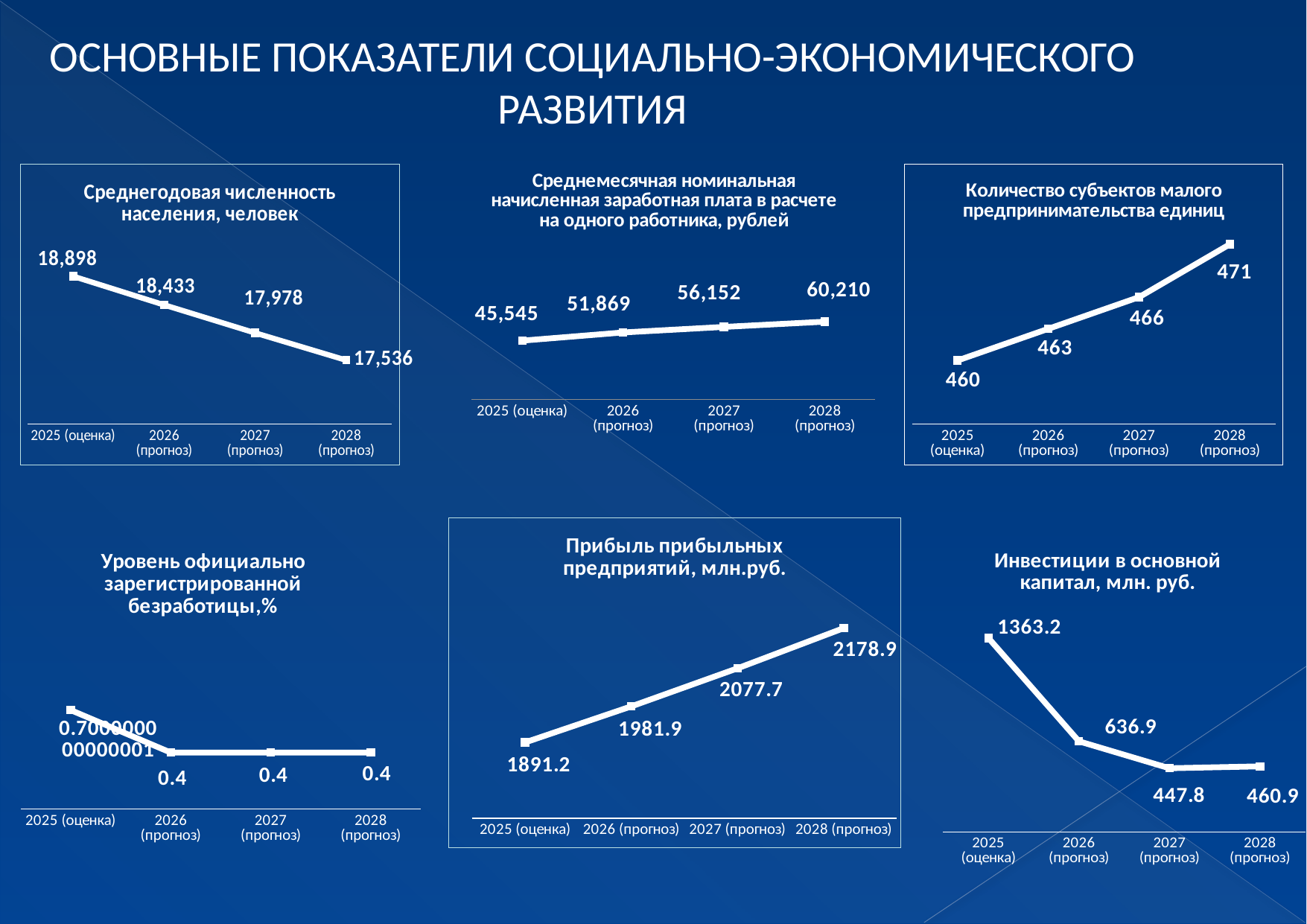
In the chart 'Прибыль прибыльных предприятий, млн.руб.', what is the value for 2025 (оценка)? 1891.2 In the chart 'Инвестиции в основной капитал, млн. руб.', which is larger: the value for 2026 or the value for 2028? 2026 In the chart 'Количество субъектов малого предпринимательства единиц', what is the difference between the 2028 and 2025 values? 11 In the chart 'Среднегодовая численность населения, человек', do the values rise or fall from 2025 to 2028? fall In the chart 'Среднемесячная номинальная начисленная заработная плата в расчете на одного работника, рублей', what is the value for 2026 (прогноз)? 51,869 In the chart 'Инвестиции в основной капитал, млн. руб.', which year has the lowest value? 2027 (прогноз) In the chart 'Количество субъектов малого предпринимательства единиц', which year has the highest value? 2028 (прогноз) How many charts are shown on the slide, and what type are they? 6 line charts In the chart 'Уровень официально зарегистрированной безработицы,%', what is the value for 2027 (прогноз)? 0.4 In the chart 'Среднемесячная номинальная начисленная заработная плата в расчете на одного работника, рублей', what is the difference between the 2028 and 2025 values? 14,665 In the chart 'Среднегодовая численность населения, человек', what is the value for 2028 (прогноз)? 17,536 In the chart 'Прибыль прибыльных предприятий, млн.руб.', what is the difference between the 2028 and 2025 values? 287.7